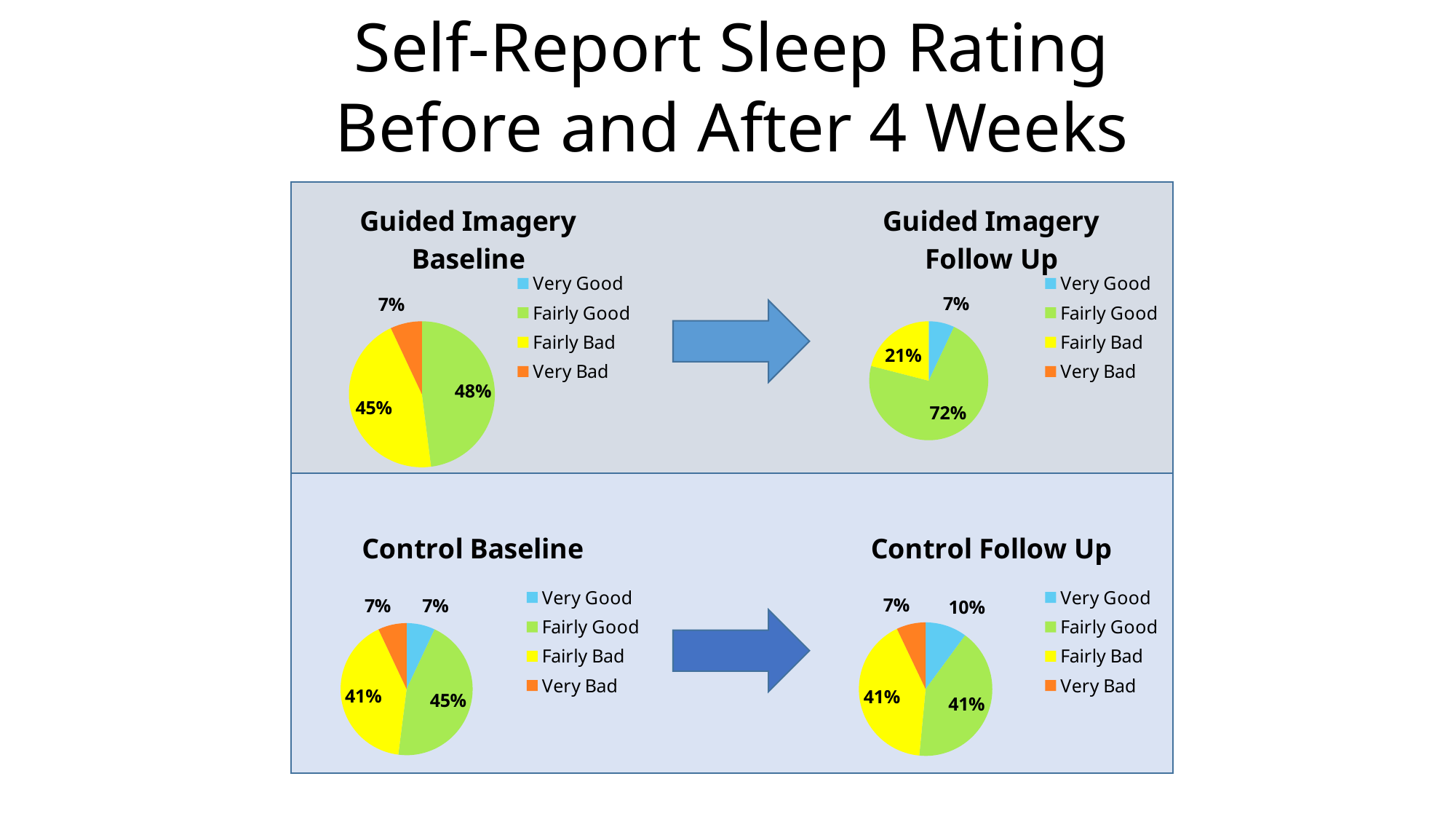
In the Guided Imagery Baseline chart, which labelled category has the smallest share? Very Bad In the Control Baseline chart, which is larger: Fairly Good or Fairly Bad? Fairly Good What colour represents Fairly Bad in the Guided Imagery Baseline chart? Yellow In the Guided Imagery Follow Up chart, what percentage is Fairly Bad? 21% In the Guided Imagery Baseline chart, what percentage is Fairly Good? 48% In the Guided Imagery Follow Up chart, which category has the largest share? Fairly Good In the Control Baseline chart, what percentage is Fairly Bad? 41% What type of chart is the Control Follow Up chart? Pie chart In the Guided Imagery Follow Up chart, what percentage is Fairly Good? 72% In the Control Follow Up chart, what percentage is Very Good? 10% What is the difference between the Fairly Good share in the Guided Imagery Follow Up chart and the Fairly Good share in the Guided Imagery Baseline chart? 24% How many categories does the legend of the Control Baseline chart list? 4